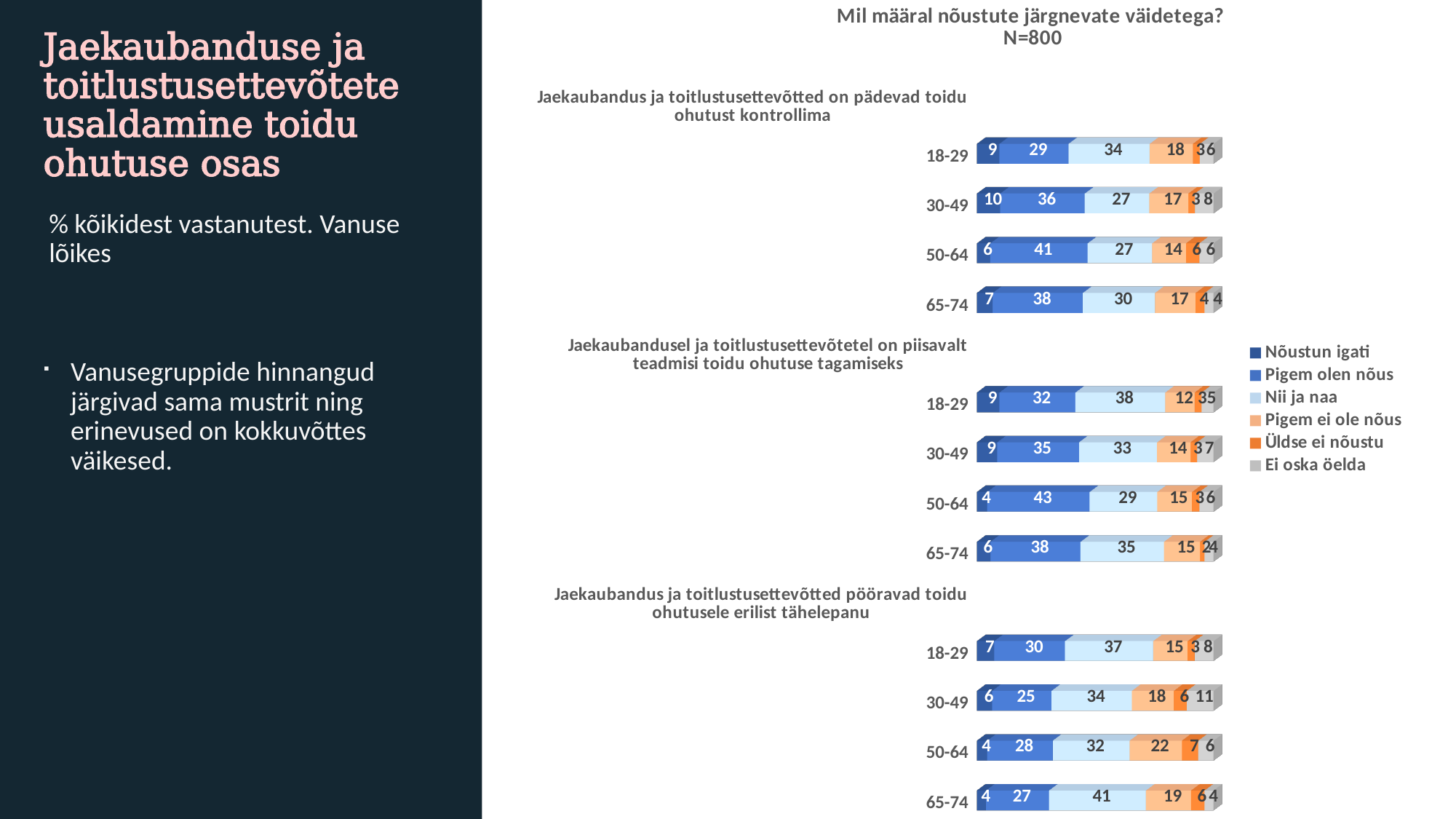
For the statement 'Jaekaubandus ja toitlustusettevõtted pööravad toidu ohutusele erilist tähelepanu', what is the difference between the 'Pigem ei ole nõus' values for the 50-64 and 18-29 age groups? 7 For the statement 'Jaekaubandus ja toitlustusettevõtted on pädevad toidu ohutust kontrollima', what is the 'Nõustun igati' value for the 30-49 age group? 10 For the statement 'Jaekaubandus ja toitlustusettevõtted on pädevad toidu ohutust kontrollima', which is larger: the 'Pigem olen nõus' value for 18-29 or for 65-74? 65-74 For the statement 'Jaekaubandusel ja toitlustusettevõtetel on piisavalt teadmisi toidu ohutuse tagamiseks', which age group has the lowest 'Nõustun igati' value? 50-64 For the statement 'Jaekaubandus ja toitlustusettevõtted pööravad toidu ohutusele erilist tähelepanu', what is the 'Ei oska öelda' value for the 30-49 age group? 11 For the statement 'Jaekaubandus ja toitlustusettevõtted on pädevad toidu ohutust kontrollima', what is the 'Pigem olen nõus' value for the 50-64 age group? 41 For the statement 'Jaekaubandus ja toitlustusettevõtted pööravad toidu ohutusele erilist tähelepanu', which age group has the highest 'Nii ja naa' value? 65-74 What kind of chart is shown on the slide? stacked bar chart What is the sample size (N) shown in the chart title? N=800 How many age groups are shown for each statement? 4 For the statement 'Jaekaubandusel ja toitlustusettevõtetel on piisavalt teadmisi toidu ohutuse tagamiseks', what is the 'Nii ja naa' value for the 18-29 age group? 38 How many series does the legend list? 6